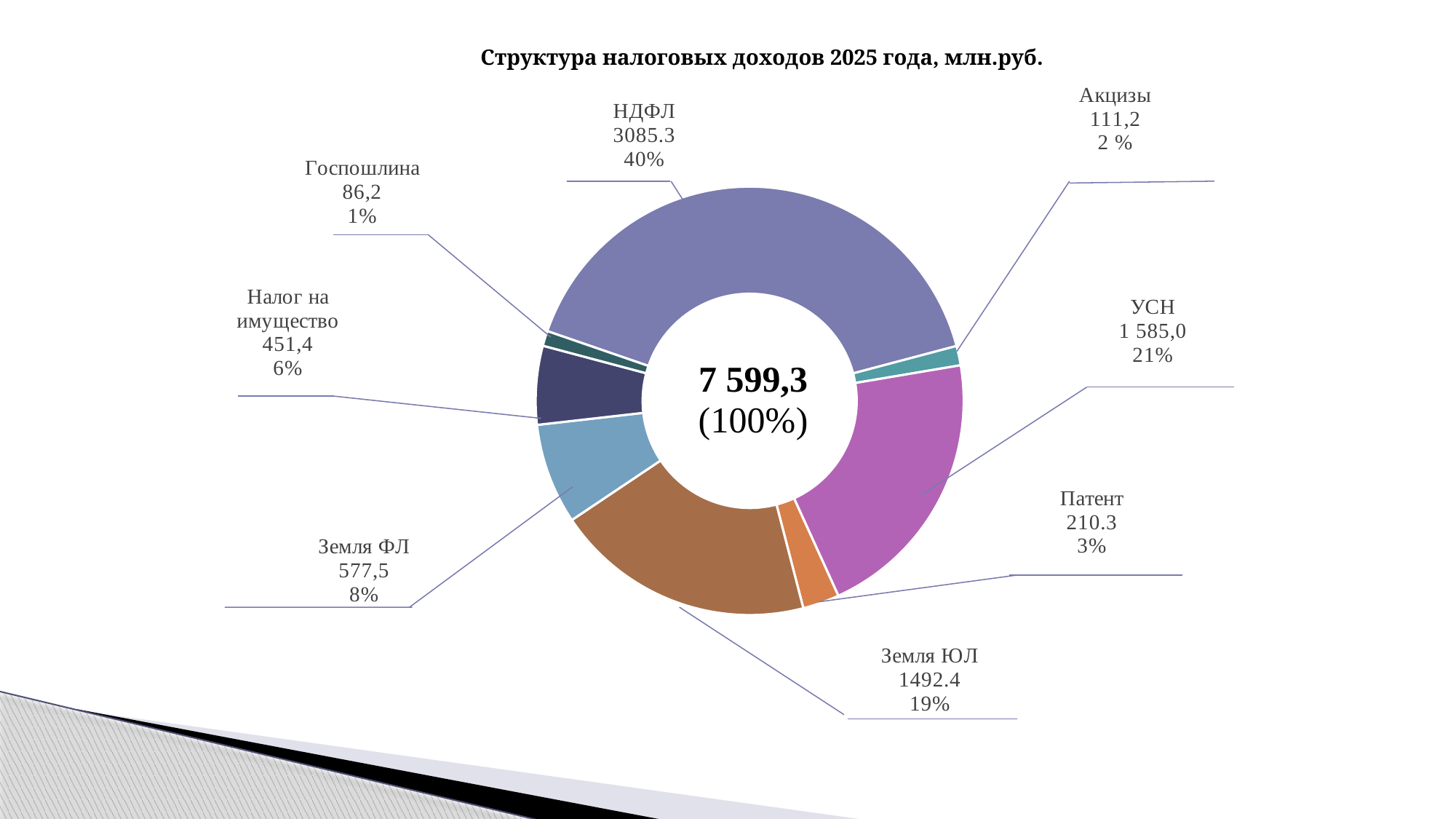
How many categories are shown in the chart? 8 What share of the total does Земля ФЛ account for? 8% What kind of chart is shown on the slide? Doughnut (pie) chart What is the value for НДФЛ? 3085.3 Which category has the smallest value? Госпошлина Which category has the largest value? НДФЛ What is the title of the chart? Структура налоговых доходов 2025 года, млн.руб. Which is larger, Земля ФЛ or Налог на имущество? Земля ФЛ What is the value for Земля ЮЛ? 1492.4 What is the difference between the values for Патент and Акцизы? 99,1 What share of the total does УСН account for? 21% What total value is shown in the centre of the chart? 7 599,3